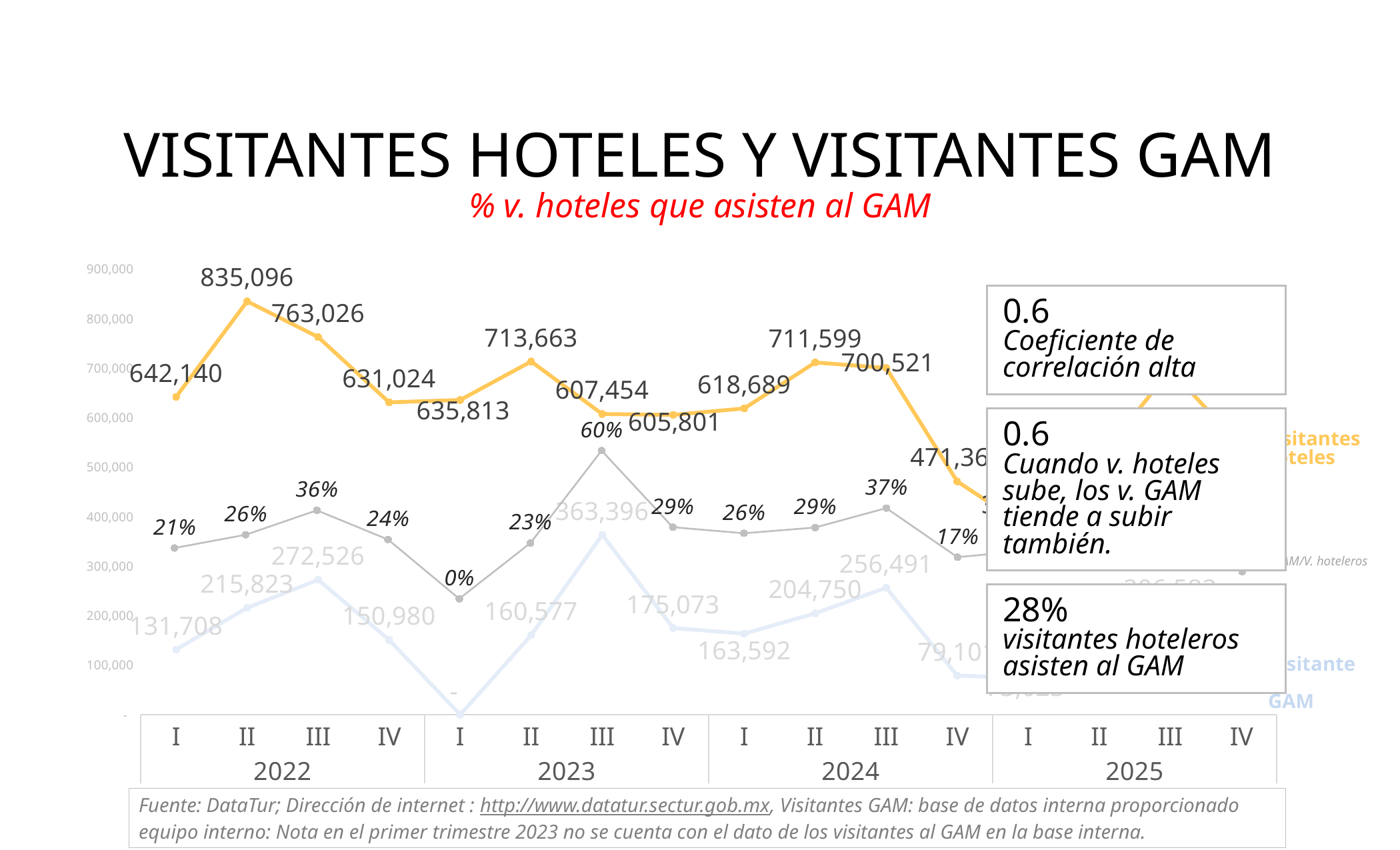
What is the difference between the Visitantes hoteles values for quarter II and quarter III of 2022? 72,070 What correlation coefficient is stated in the text box on the slide? 0.6 What is the Visitantes GAM value for quarter III of 2023? 363,396 In which quarter does the Visitantes hoteles line reach its highest point? II 2022 Does the Visitantes hoteles line rise or fall from quarter III to quarter IV of 2024? fall What is the highest percentage label shown on the grey line? 60% Which is larger: the Visitantes hoteles value for quarter III of 2022 or for quarter II of 2023? III 2022 According to the text box, what percentage of visitantes hoteleros attend the GAM? 28% Is the Visitantes hoteles value for quarter IV of 2024 greater or less than 500,000? less What kind of chart is shown on the slide? line chart What is the Visitantes hoteles value for quarter II of 2022? 835,096 What percentage is shown for quarter III of 2022 on the grey line? 36%